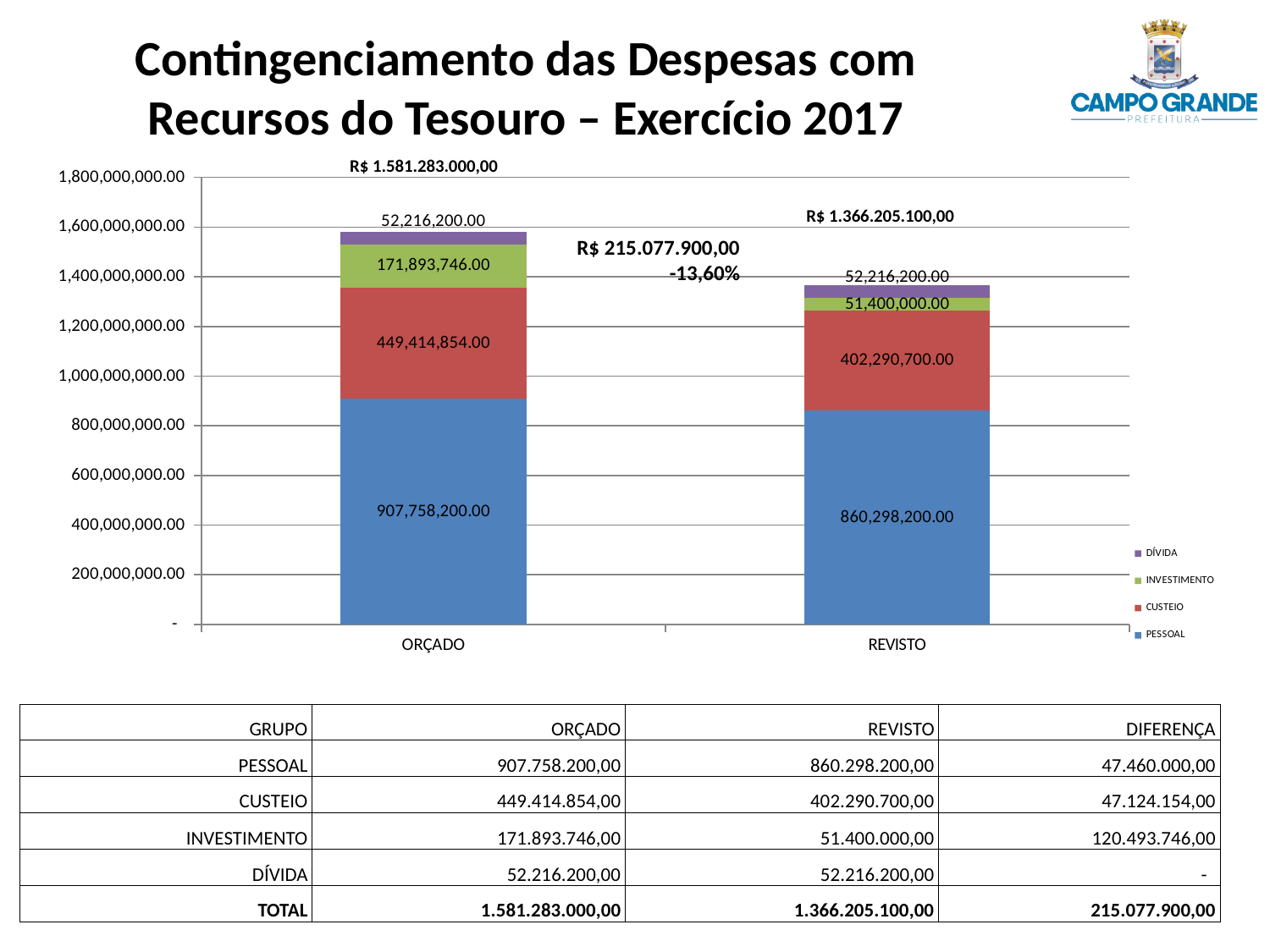
What is the total of the stacked bar for REVISTO, as labelled on the chart? R$ 1.366.205.100,00 How many categories are shown on the x axis of the chart? 2 What is the value of CUSTEIO for REVISTO in the chart? 402,290,700.00 What is the value of INVESTIMENTO for ORÇADO in the chart? 171,893,746.00 Which category has the larger INVESTIMENTO value, ORÇADO or REVISTO? ORÇADO What is the value of PESSOAL for ORÇADO in the chart? 907,758,200.00 What is the value of DÍVIDA for REVISTO in the chart? 52,216,200.00 What kind of chart is shown on the slide? stacked bar chart How many series does the chart legend list? 4 What is the total of the stacked bar for ORÇADO, as labelled on the chart? R$ 1.581.283.000,00 What is the difference between the PESSOAL values for ORÇADO and REVISTO? 47,460,000.00 Which series is shown in blue in the chart? PESSOAL